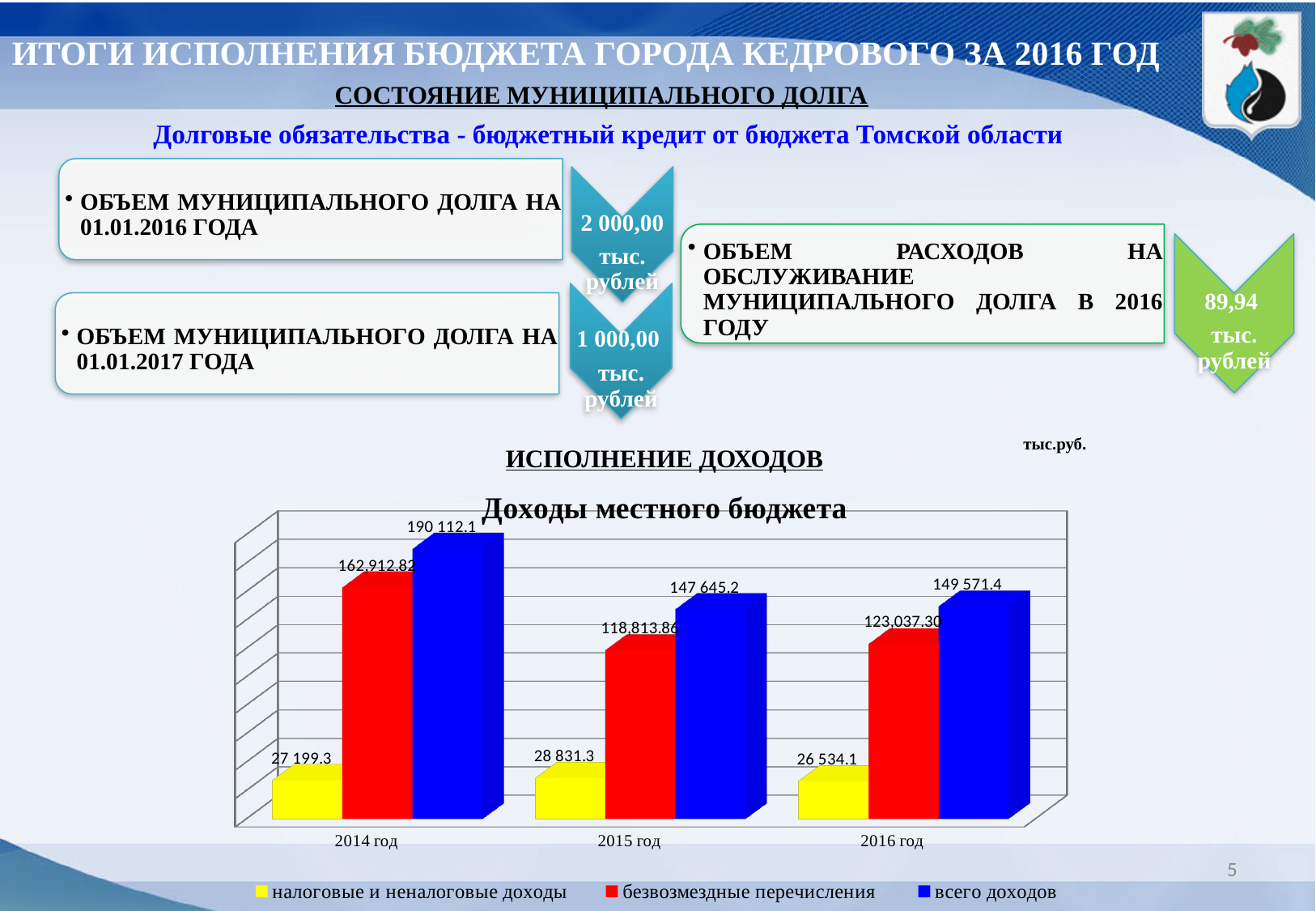
In the chart "Доходы местного бюджета", which year has the lowest value of налоговые и неналоговые доходы? 2016 год In the chart "Доходы местного бюджета", does всего доходов rise or fall from 2014 год to 2015 год? fall How many series does the legend of the chart "Доходы местного бюджета" list? 3 In the chart "Доходы местного бюджета", which colour represents всего доходов? blue In the chart "Доходы местного бюджета", what is the value of всего доходов for 2014 год? 190 112.1 In the chart "Доходы местного бюджета", what is the difference between всего доходов in 2014 год and 2015 год? 42 466.9 In the chart "Доходы местного бюджета", which year has the highest value of всего доходов? 2014 год In the chart "Доходы местного бюджета", which is larger: безвозмездные перечисления in 2015 год or in 2016 год? 2016 год In the chart "Доходы местного бюджета", what is the value of безвозмездные перечисления for 2015 год? 118,813.86 What type of chart is "Доходы местного бюджета"? bar chart How many years are shown on the x axis of the chart "Доходы местного бюджета"? 3 In the chart "Доходы местного бюджета", what is the value of налоговые и неналоговые доходы for 2016 год? 26 534.1